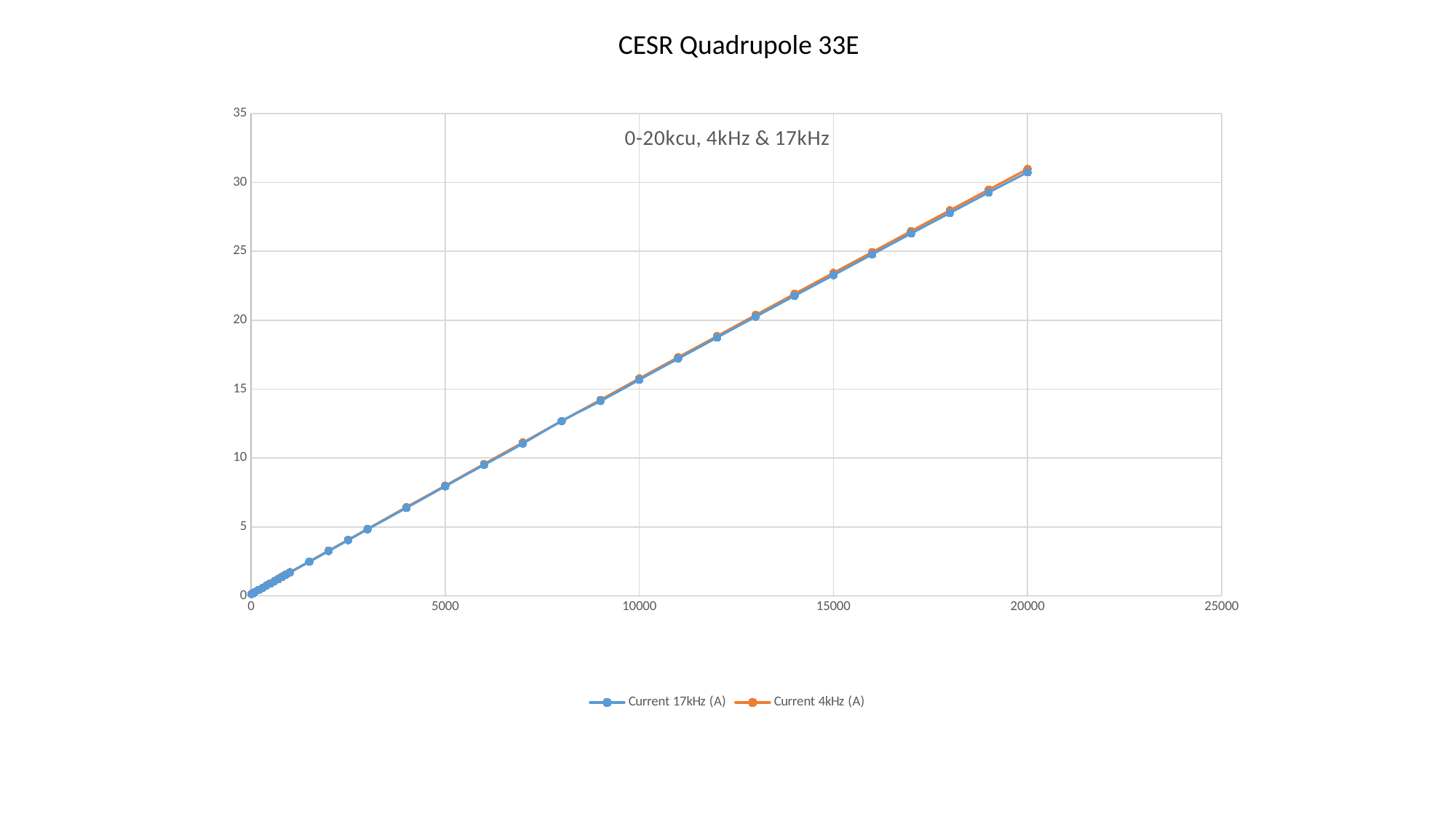
Is the value of Current 17kHz (A) at x = 20000 greater or less than 30? greater Is the value of Current 4kHz (A) at x = 10000 greater or less than 20? less Is the value of Current 17kHz (A) at x = 15000 greater or less than 20? greater How many series does the legend list? 2 What is the title of the chart? 0-20kcu, 4kHz & 17kHz What are the two series named in the legend? Current 17kHz (A) and Current 4kHz (A) What kind of chart is shown on the slide? line chart Do the values of the Current 17kHz (A) series rise or fall as the x axis increases? rise